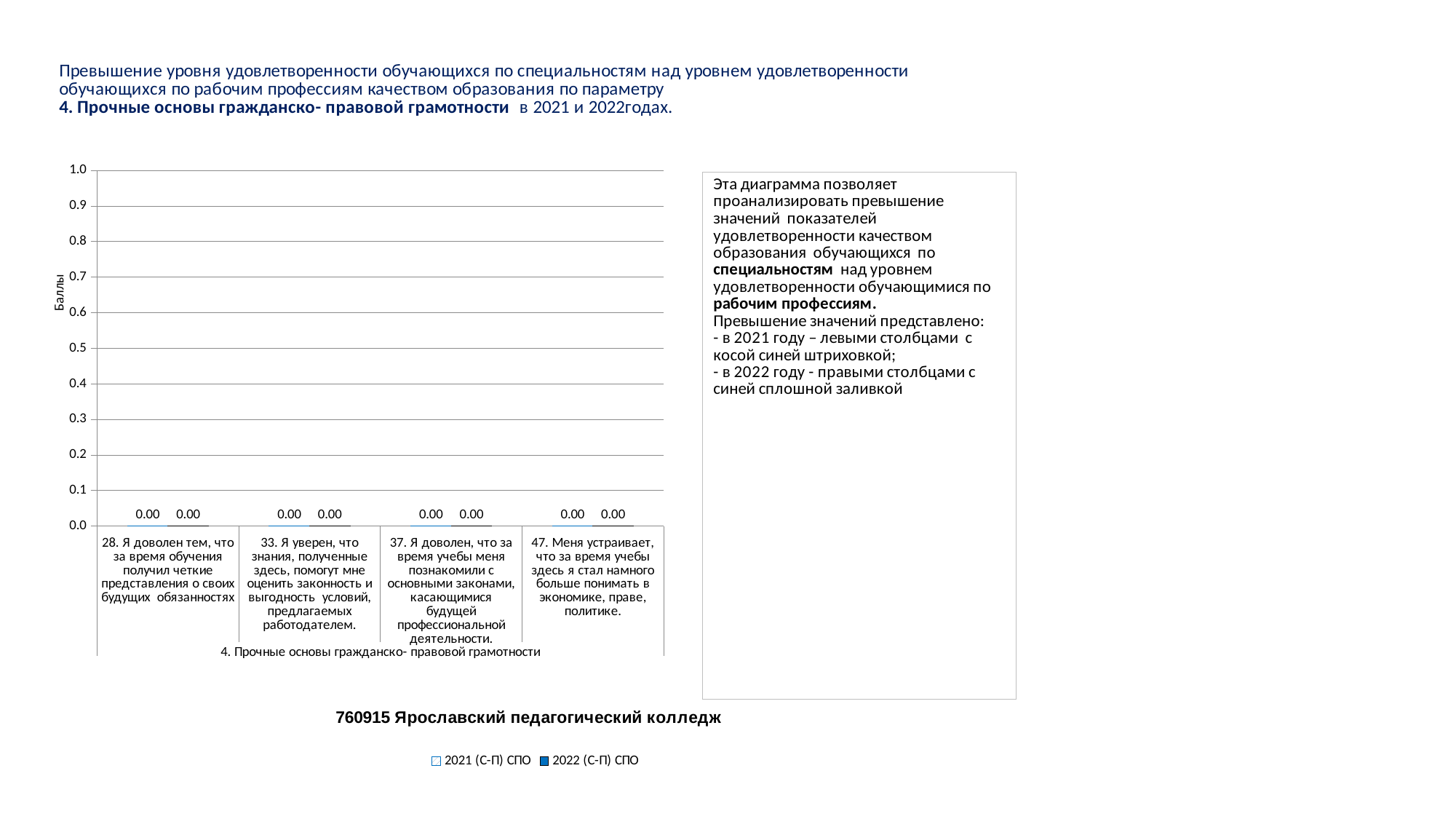
How many categories are shown on the x axis of the chart? 4 What is the value for 2022 (С-П) СПО for category 47 (Меня устраивает, что за время учебы здесь я стал намного больше понимать в экономике, праве, политике)? 0.00 What is the label of the vertical axis of the chart? Баллы What is the value for 2021 (С-П) СПО for category 28 (Я доволен тем, что за время обучения получил четкие представления о своих будущих обязанностях)? 0.00 How many series does the legend list? 2 What is the difference between the 2022 (С-П) СПО and 2021 (С-П) СПО values for category 28? 0.00 What is the value for 2022 (С-П) СПО for category 33 (Я уверен, что знания, полученные здесь, помогут мне оценить законность и выгодность условий, предлагаемых работодателем)? 0.00 Do the values for 2022 (С-П) СПО rise, fall, or stay the same across the categories on the x axis? stay the same What is the value for 2021 (С-П) СПО for category 37 (Я доволен, что за время учебы меня познакомили с основными законами, касающимися будущей профессиональной деятельности)? 0.00 Is the value for 2021 (С-П) СПО for category 47 greater or less than 0.1? less What type of chart is shown on the slide? bar chart What is the title shown below the chart? 760915 Ярославский педагогический колледж